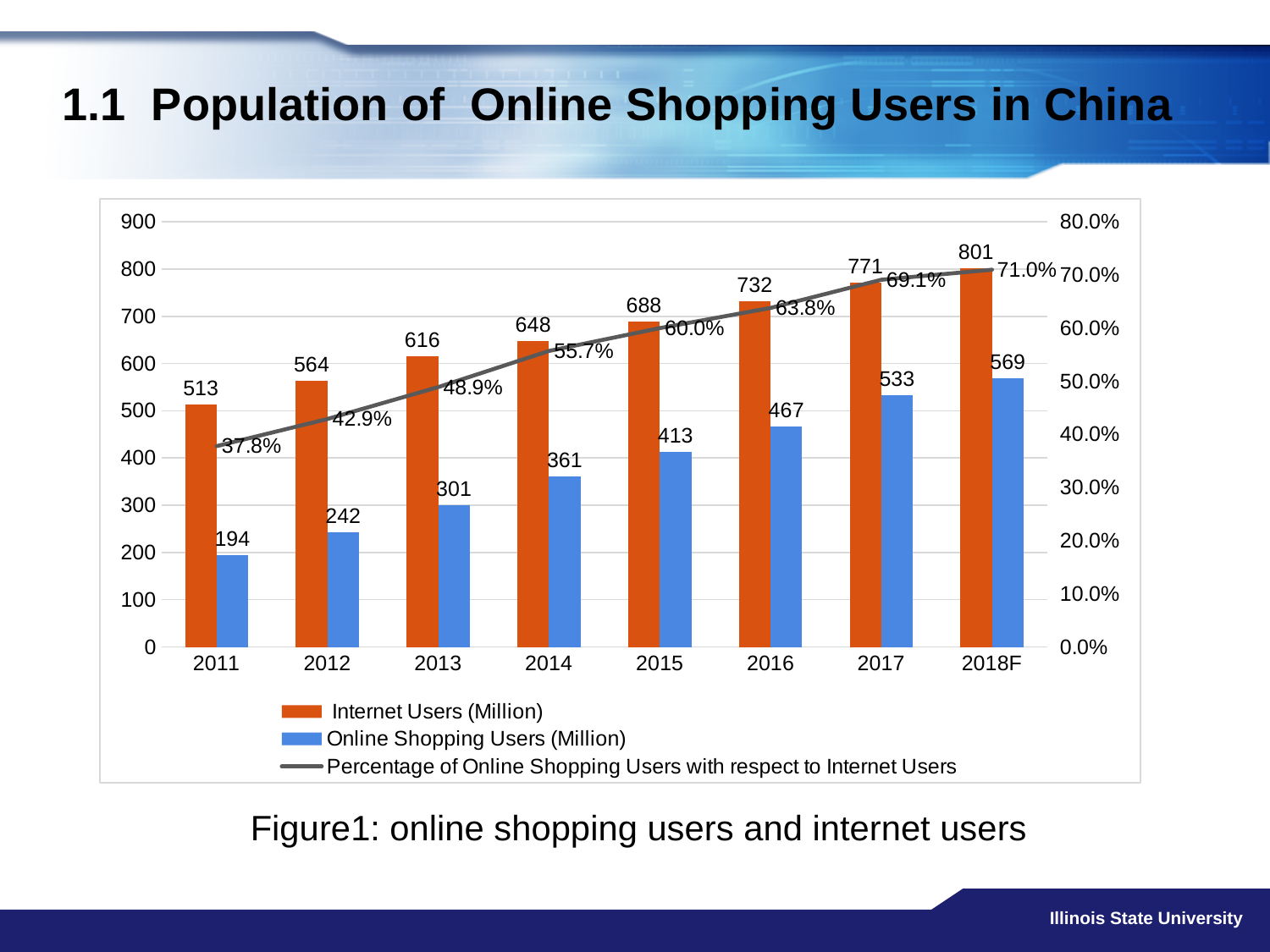
What kind of chart is this? Combined bar and line chart How many series does the legend list? 3 How many years are shown on the x axis? 8 What is the Percentage of Online Shopping Users with respect to Internet Users in 2012? 42.9% Which year has the lowest value for Internet Users (Million)? 2011 Which is larger: Online Shopping Users (Million) in 2016 or Internet Users (Million) in 2011? Internet Users (Million) in 2011 What colour are the bars for Online Shopping Users (Million)? Blue Does the Percentage of Online Shopping Users with respect to Internet Users rise or fall from 2011 to 2018F? Rise What is the value for Online Shopping Users (Million) in 2013? 301 What is the difference between Internet Users (Million) and Online Shopping Users (Million) in 2017? 238 Which year has the highest value for Online Shopping Users (Million)? 2018F What is the value for Internet Users (Million) in 2015? 688